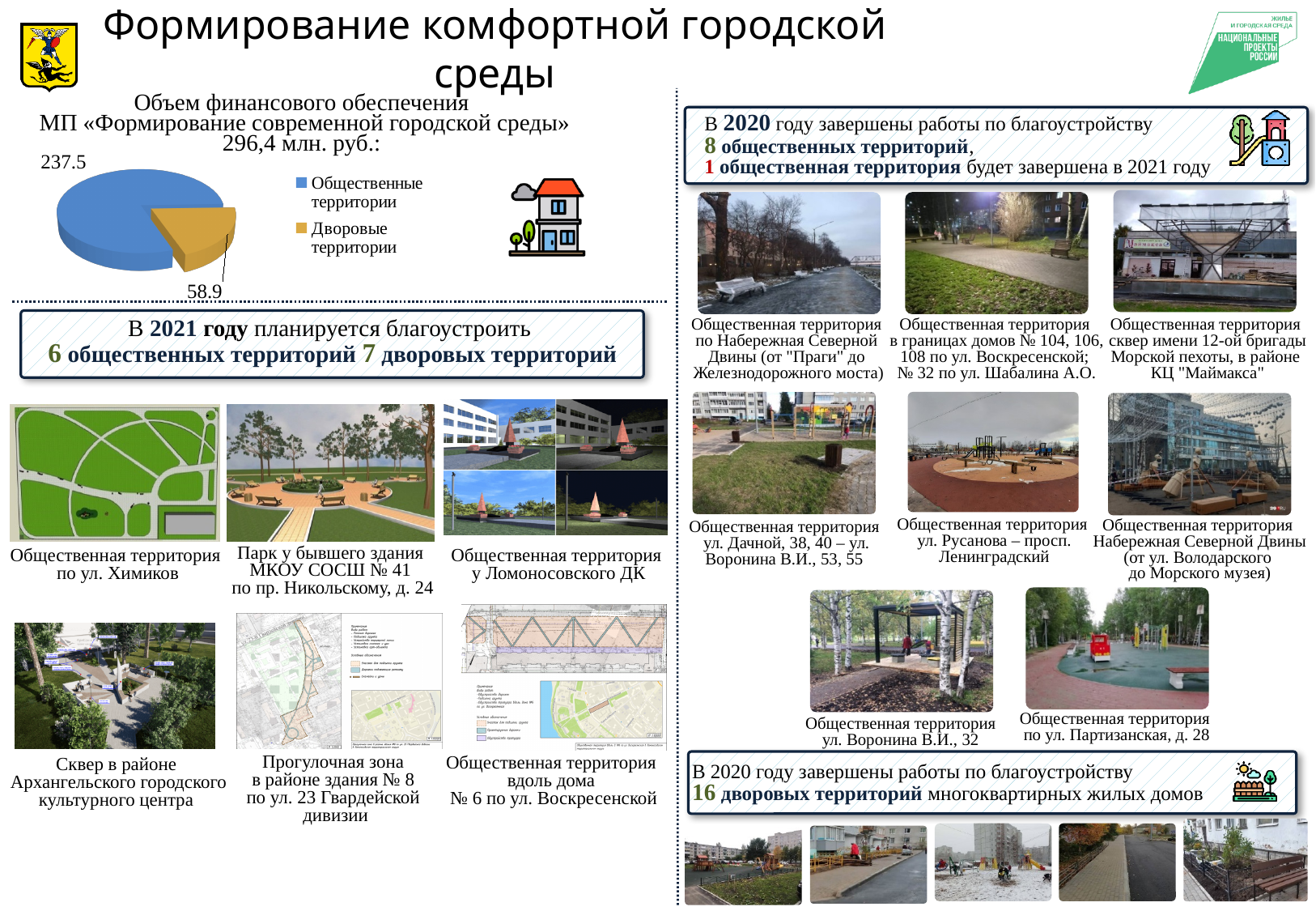
What is the difference between the values for Общественные территории and Дворовые территории? 178.6 What total amount in million rubles is stated in the pie chart's title? 296,4 млн. руб. How many entries does the legend of the pie chart list? 2 What is the value for Дворовые территории in the pie chart? 58.9 What colour is the slice for Дворовые территории in the pie chart? yellow Which category has the smallest slice in the pie chart? Дворовые территории Which category has the largest slice in the pie chart? Общественные территории Which is larger: the value for Общественные территории or for Дворовые территории? Общественные территории What is the value for Общественные территории in the pie chart? 237.5 How many slices does the pie chart have? 2 What type of chart is shown on the slide? pie chart